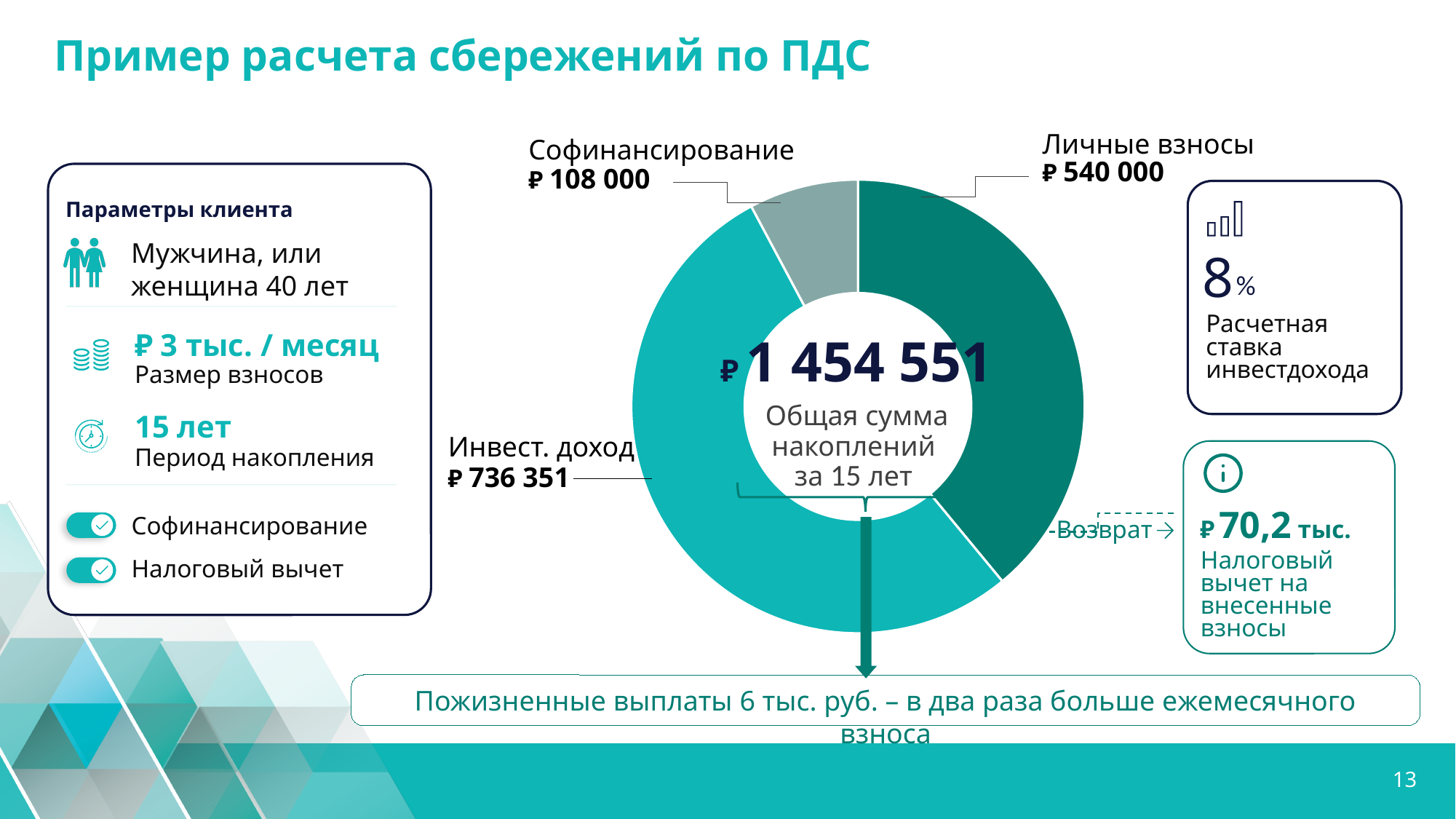
What does the text in the centre of the donut chart say the total represents? Общая сумма накоплений за 15 лет Which is larger: "Инвест. доход" or "Личные взносы"? Инвест. доход Which segment of the donut chart is the largest? Инвест. доход What is the difference between "Личные взносы" and "Софинансирование"? ₽ 432 000 What is the value of the "Личные взносы" segment? ₽ 540 000 What is the difference between "Инвест. доход" and "Личные взносы"? ₽ 196 351 What is the value of the "Софинансирование" segment? ₽ 108 000 Which segment of the donut chart is the smallest? Софинансирование How many segments does the donut chart have? 3 What total is printed in the centre of the donut chart? ₽ 1 454 551 What is the value of the "Инвест. доход" segment? ₽ 736 351 What type of chart is shown on the slide? Pie (donut) chart